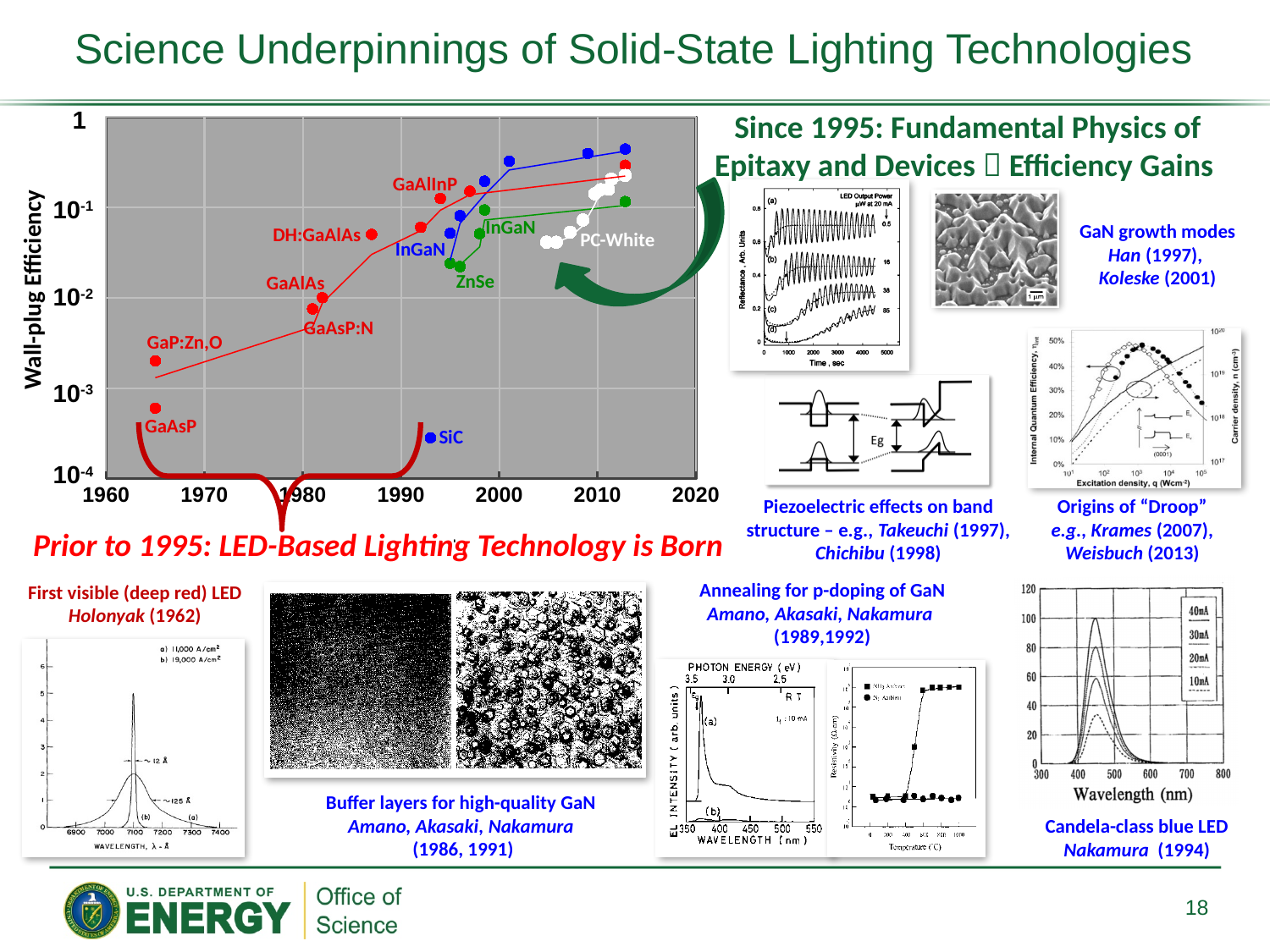
In the large wall-plug efficiency chart, is the value for GaP:Zn,O greater or less than 10^-3? greater In the large wall-plug efficiency chart, how many year tick labels are shown on the x axis? 7 In the large wall-plug efficiency chart, is the value for SiC greater or less than 10^-3? less In the large wall-plug efficiency chart, is the value for GaAlInP greater or less than 10^-1? greater In the large wall-plug efficiency chart, which has the higher wall-plug efficiency, GaP:Zn,O or GaAsP? GaP:Zn,O What is the y-axis label of the large chart on the left of the slide? Wall-plug Efficiency In the large wall-plug efficiency chart, which has the higher wall-plug efficiency, GaAlInP or ZnSe? GaAlInP In the large wall-plug efficiency chart, does wall-plug efficiency generally rise or fall from 1960 to 2020? rise In the Candela-class blue LED chart at the bottom right, how many current values does the legend list? 4 In the large wall-plug efficiency chart, what is the earliest year shown on the x axis? 1960